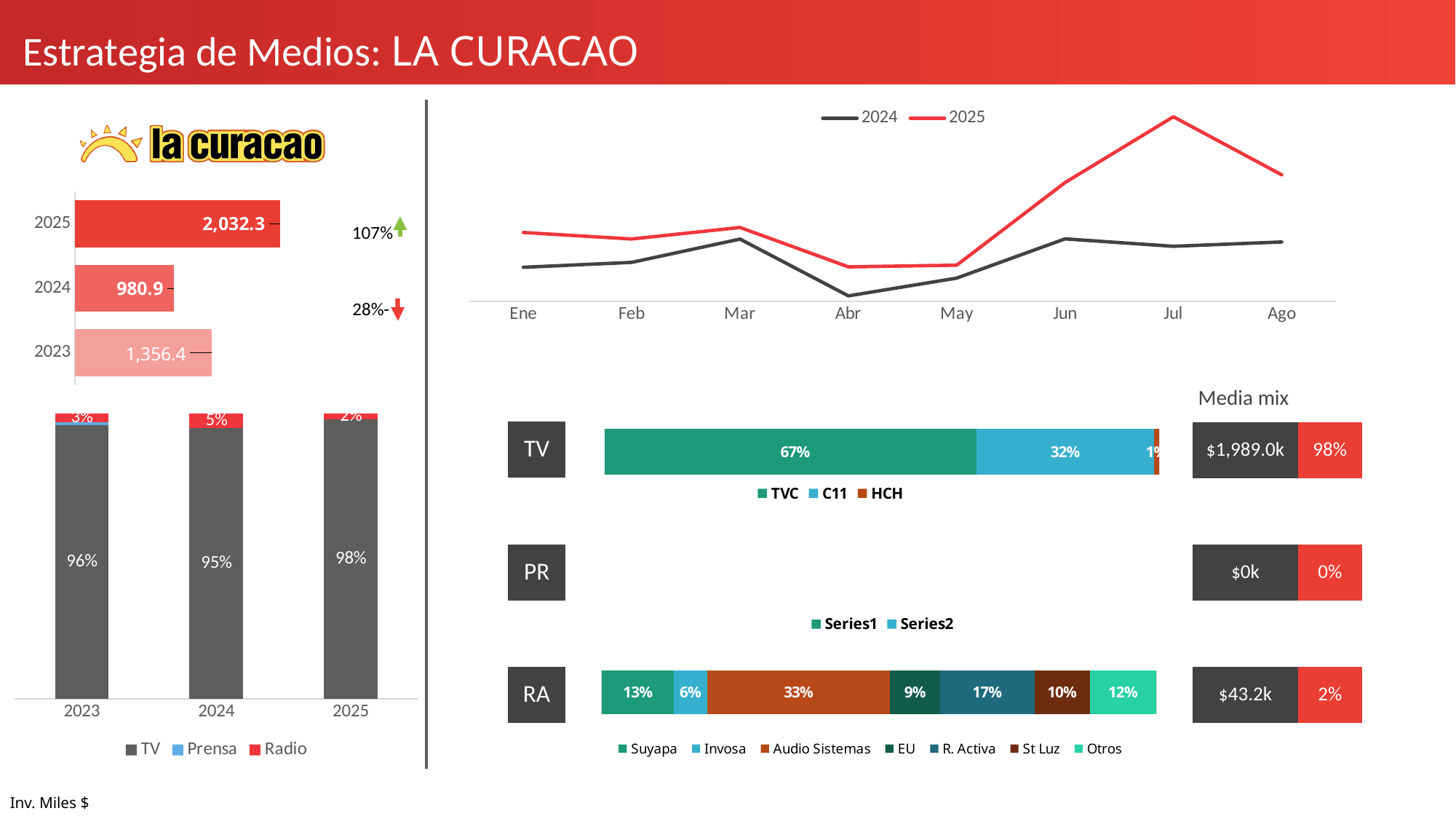
In the horizontal bar chart of yearly investment on the left, what is the value for 2025? 2,032.3 In the stacked bar chart of media share by year at the bottom left, what is the Radio share for 2025? 2% In the horizontal bar chart of yearly investment on the left, which year has the lowest value? 2024 In the horizontal bar chart of yearly investment on the left, what is the difference between the 2025 and 2024 values? 1,051.4 In the stacked bar chart of media share by year at the bottom left, what is the TV share for 2024? 95% In the line chart at the top right, how many months are shown on the x axis? 8 How many series does the legend of the stacked bar chart at the bottom left list? 3 In the RA stacked bar on the right, which channel has the largest share? Audio Sistemas In the horizontal bar chart of yearly investment on the left, what is the value for 2024? 980.9 In the TV stacked bar on the right, what is the share for C11? 32% In the horizontal bar chart of yearly investment on the left, which year has the highest value? 2025 In the line chart at the top right, in which month does the 2025 line reach its highest point? Jul